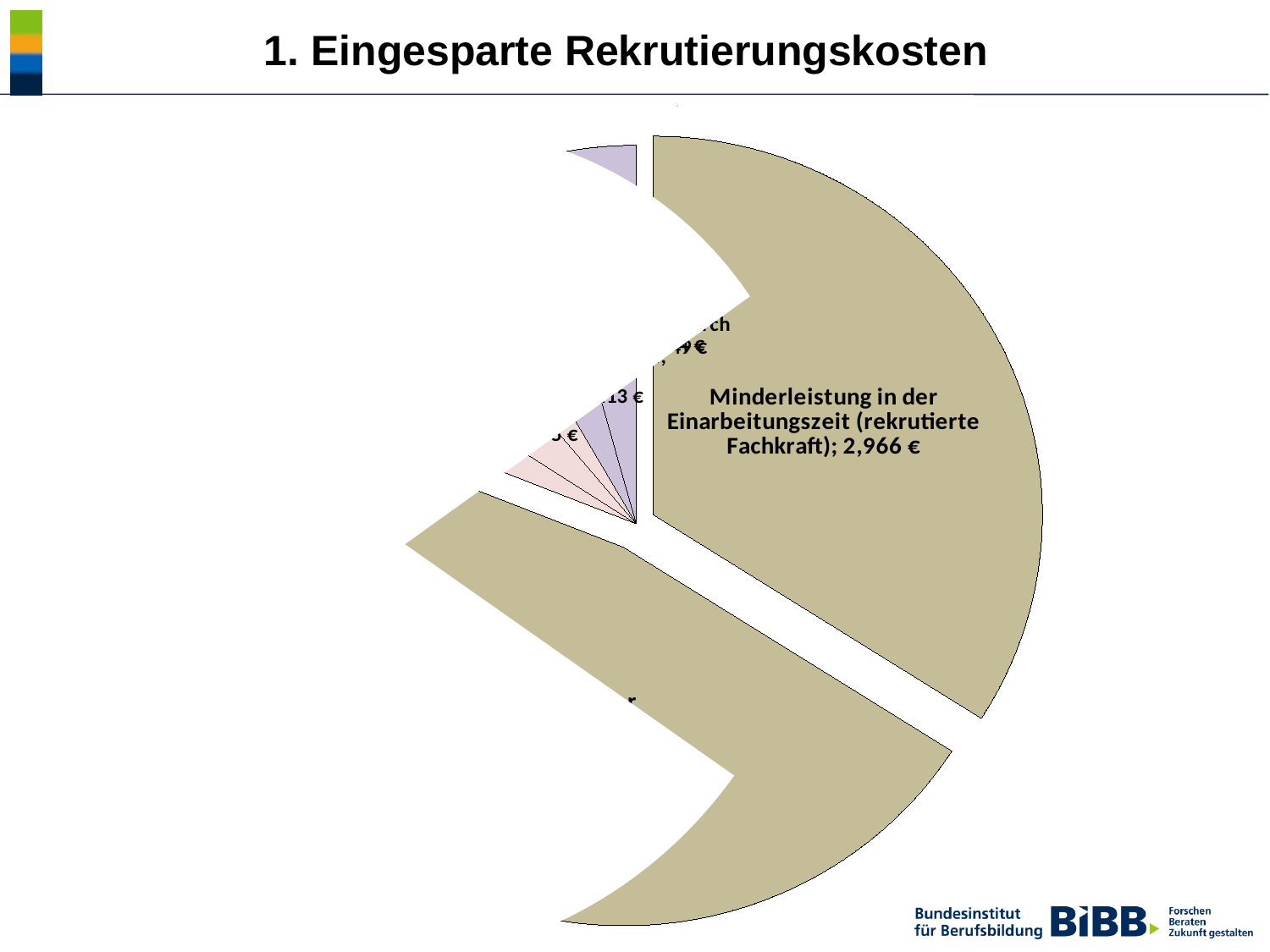
What kind of chart is shown on the slide? pie chart What value is shown for the slice labelled "Minderleistung in der Einarbeitungszeit (rekrutierte Fachkraft)"? 2,966 € What is the title of the slide containing the pie chart? 1. Eingesparte Rekrutierungskosten